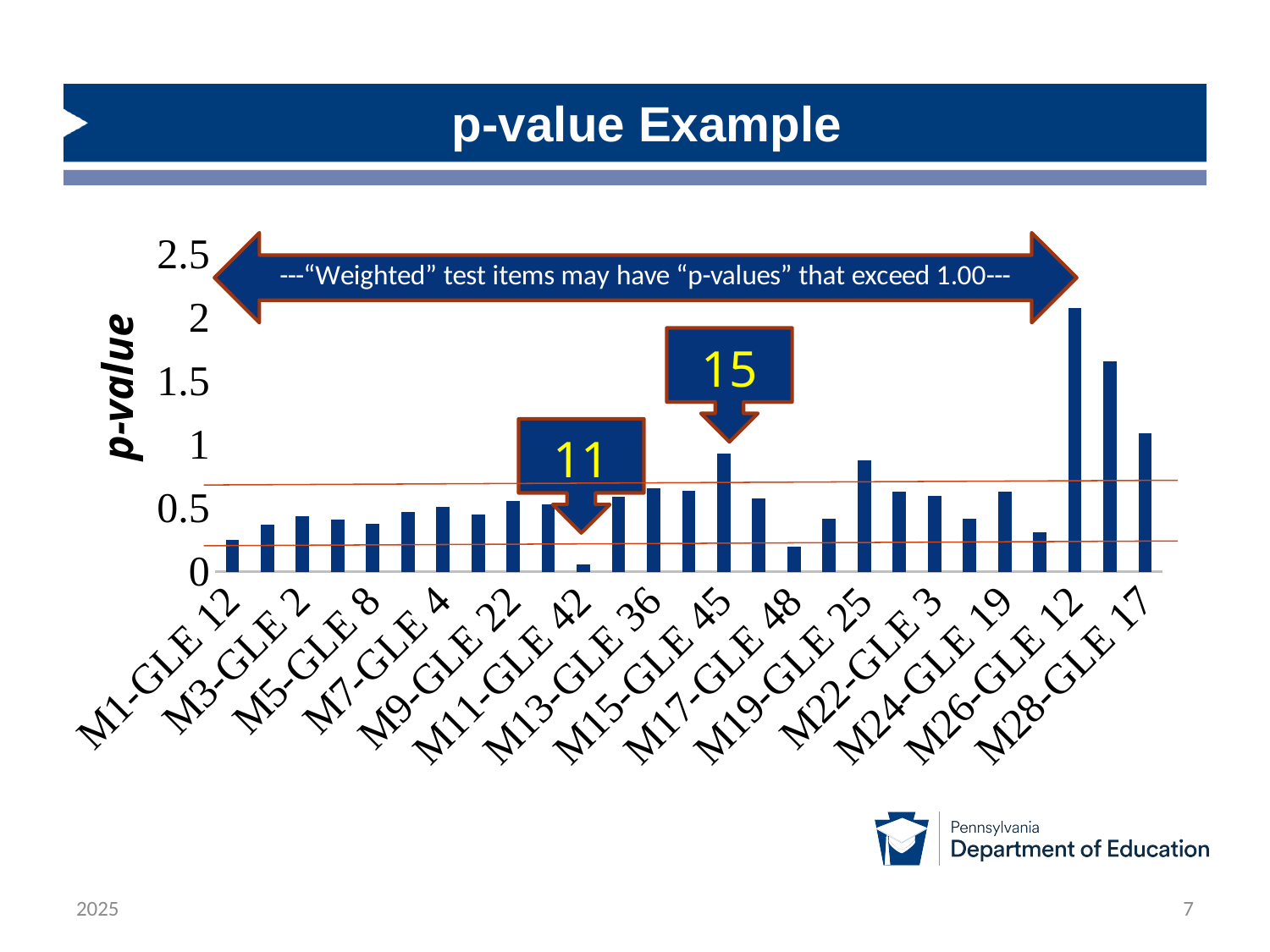
Is the value for M1-GLE 12 greater or less than 0.5? less What kind of chart is shown on the slide? bar chart Is the value for M28-GLE 17 greater or less than 0.5? greater What is the label on the vertical axis of the chart? p-value Is the value for M26-GLE 12 greater or less than 1.5? greater What is the title of the chart on the slide? p-value Example Which has the larger p-value, M26-GLE 12 or M1-GLE 12? M26-GLE 12 Which has the larger p-value, M15-GLE 45 or M3-GLE 2? M15-GLE 45 Which labeled category has the highest p-value in the chart? M26-GLE 12